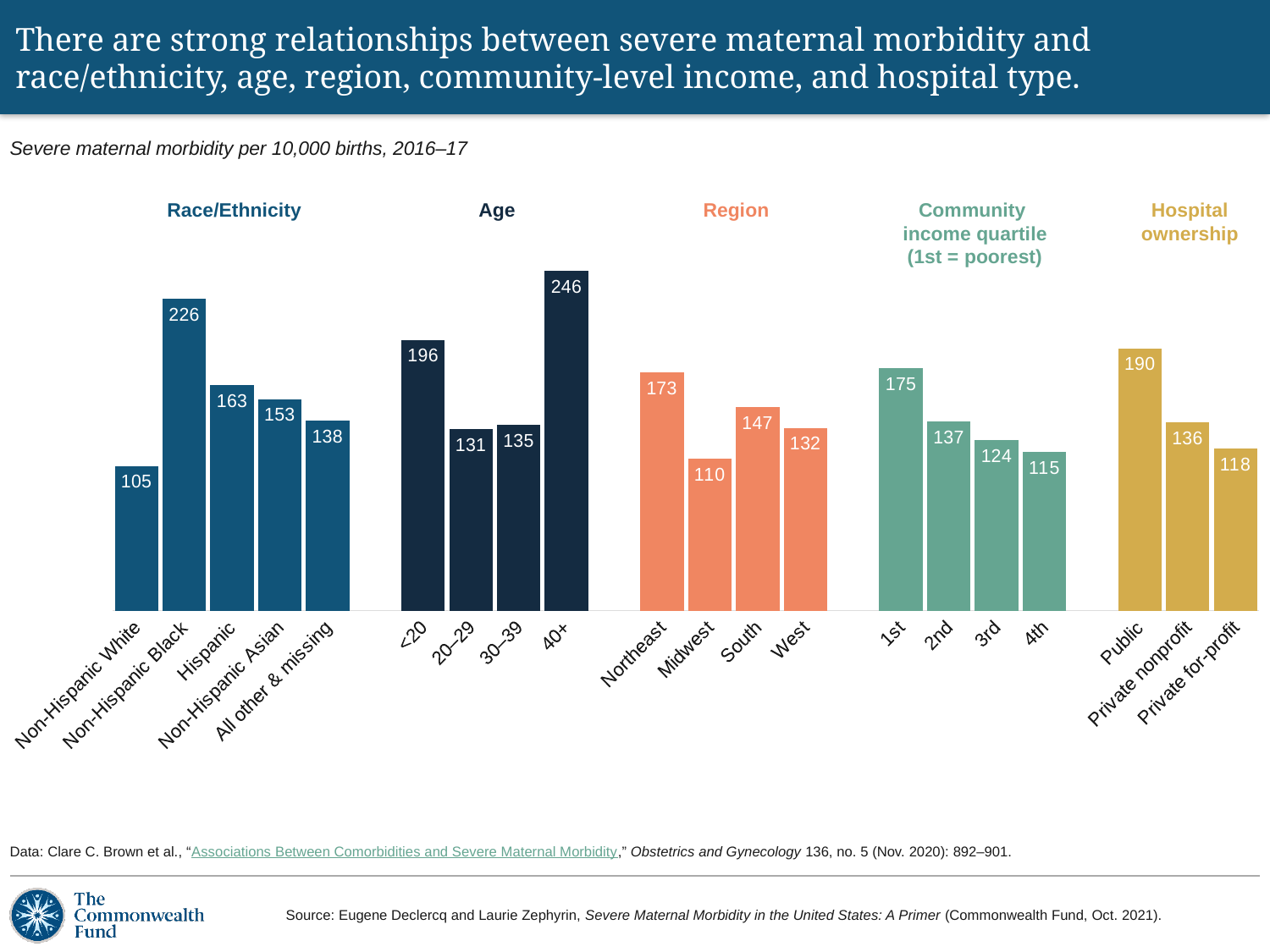
Which is larger, the rate for the South region or the West region? South What is the value shown for the Midwest region? 110 What is the difference between the rates for Public and Private for-profit hospitals? 72 What is the value shown for the 40+ age group? 246 What type of chart is shown on the slide? Bar chart What is the value for the 1st (poorest) community income quartile? 175 Which hospital ownership category has the highest severe maternal morbidity rate? Public Do the values fall or rise across the community income quartiles from 1st to 4th? Fall What is the difference between the rates for Non-Hispanic Black and Non-Hispanic White? 121 How many age groups are shown in the chart? 4 Which race/ethnicity group has the lowest severe maternal morbidity rate? Non-Hispanic White What is the severe maternal morbidity rate per 10,000 births for Non-Hispanic Black? 226